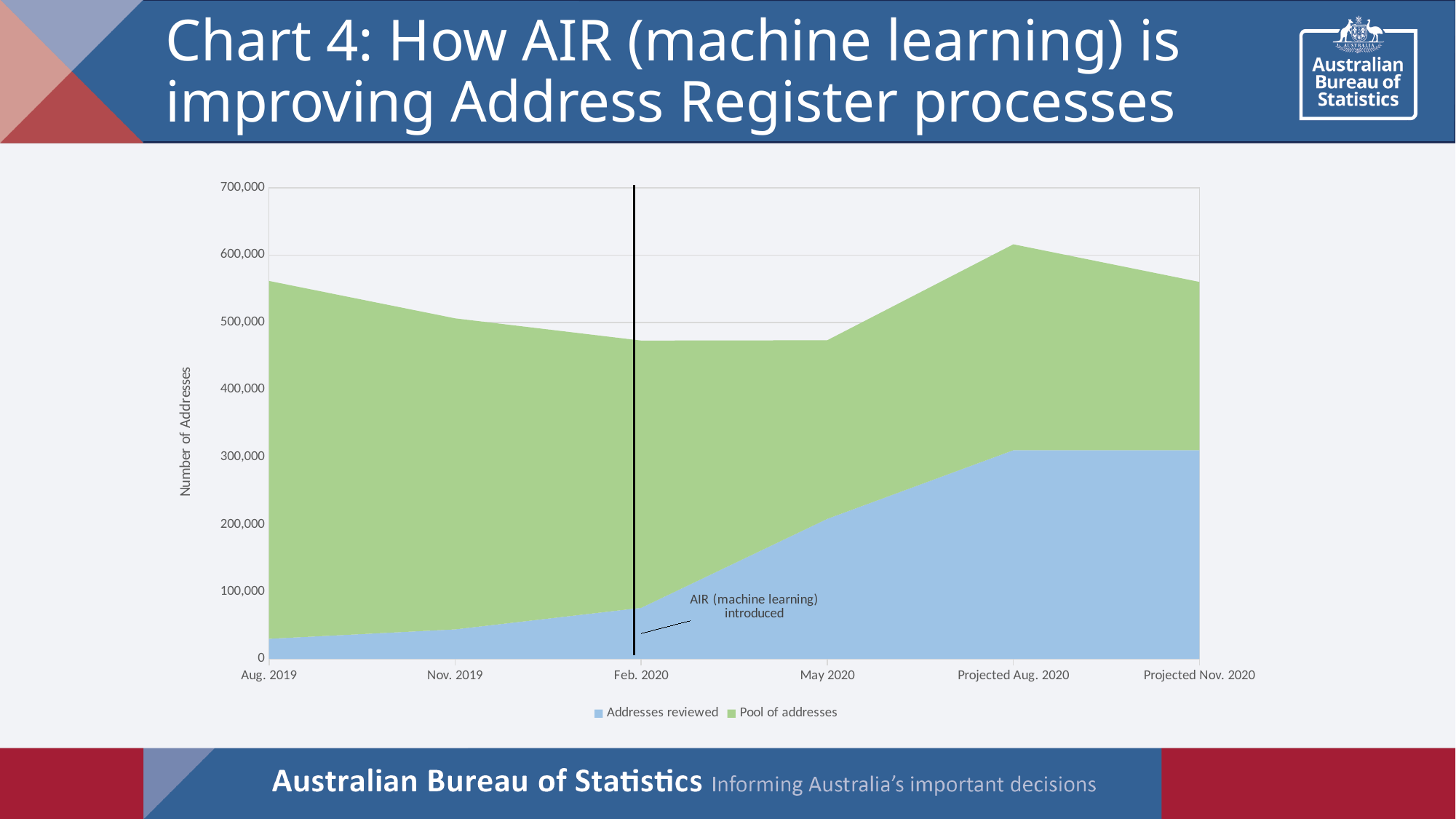
At which x-axis period is the vertical line marking 'AIR (machine learning) introduced' placed? Feb. 2020 Which series is shown in blue? Addresses reviewed How many series does the legend list? 2 Is the value for Addresses reviewed in Projected Aug. 2020 greater or less than 300,000? greater How many time periods are shown on the x axis? 6 Is the combined total of both series in Projected Aug. 2020 greater or less than 600,000? greater What kind of chart is shown on the slide? Stacked area chart Is the value for Addresses reviewed in Feb. 2020 greater or less than 100,000? less In which period is the combined total of Addresses reviewed and Pool of addresses highest? Projected Aug. 2020 Which is larger: Addresses reviewed in May 2020 or Addresses reviewed in Nov. 2019? May 2020 In which period is the value for Addresses reviewed lowest? Aug. 2019 Does the value for Addresses reviewed rise or fall from Aug. 2019 to Projected Aug. 2020? rise